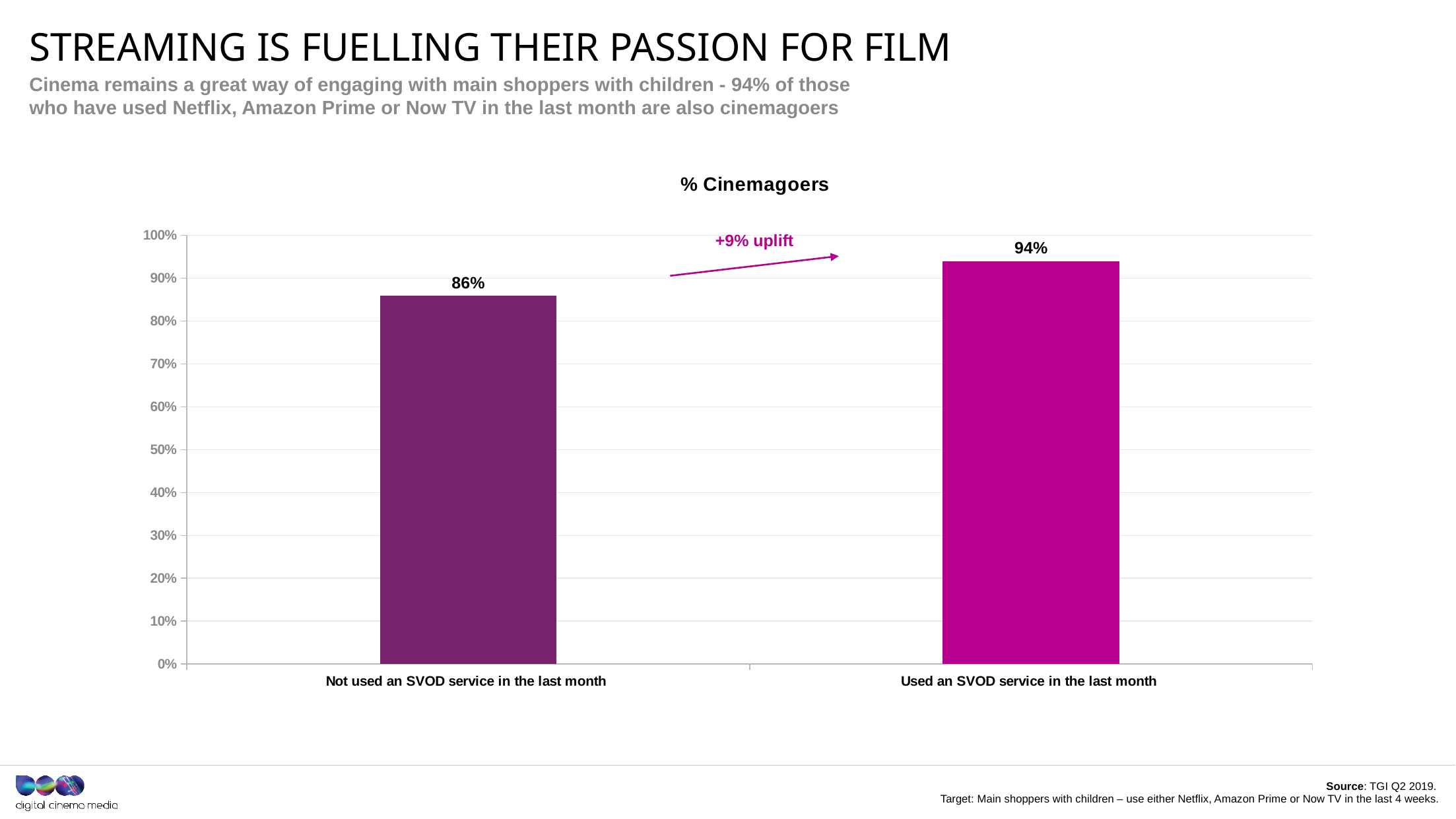
What is the value for 'Used an SVOD service in the last month'? 94% What kind of chart is shown on the slide? Bar chart How many categories are shown in the chart? 2 What is the difference between the values for 'Used an SVOD service in the last month' and 'Not used an SVOD service in the last month'? 8% Which category has the highest percentage of cinemagoers? Used an SVOD service in the last month Is the value for 'Not used an SVOD service in the last month' greater or less than 90%? less What uplift is annotated on the chart between the two bars? +9% uplift What is the value for 'Not used an SVOD service in the last month'? 86% Which is larger: the value for 'Used an SVOD service in the last month' or 'Not used an SVOD service in the last month'? Used an SVOD service in the last month What is the title of the chart? % Cinemagoers Is the value for 'Used an SVOD service in the last month' greater or less than 90%? greater Which category has the lowest percentage of cinemagoers? Not used an SVOD service in the last month